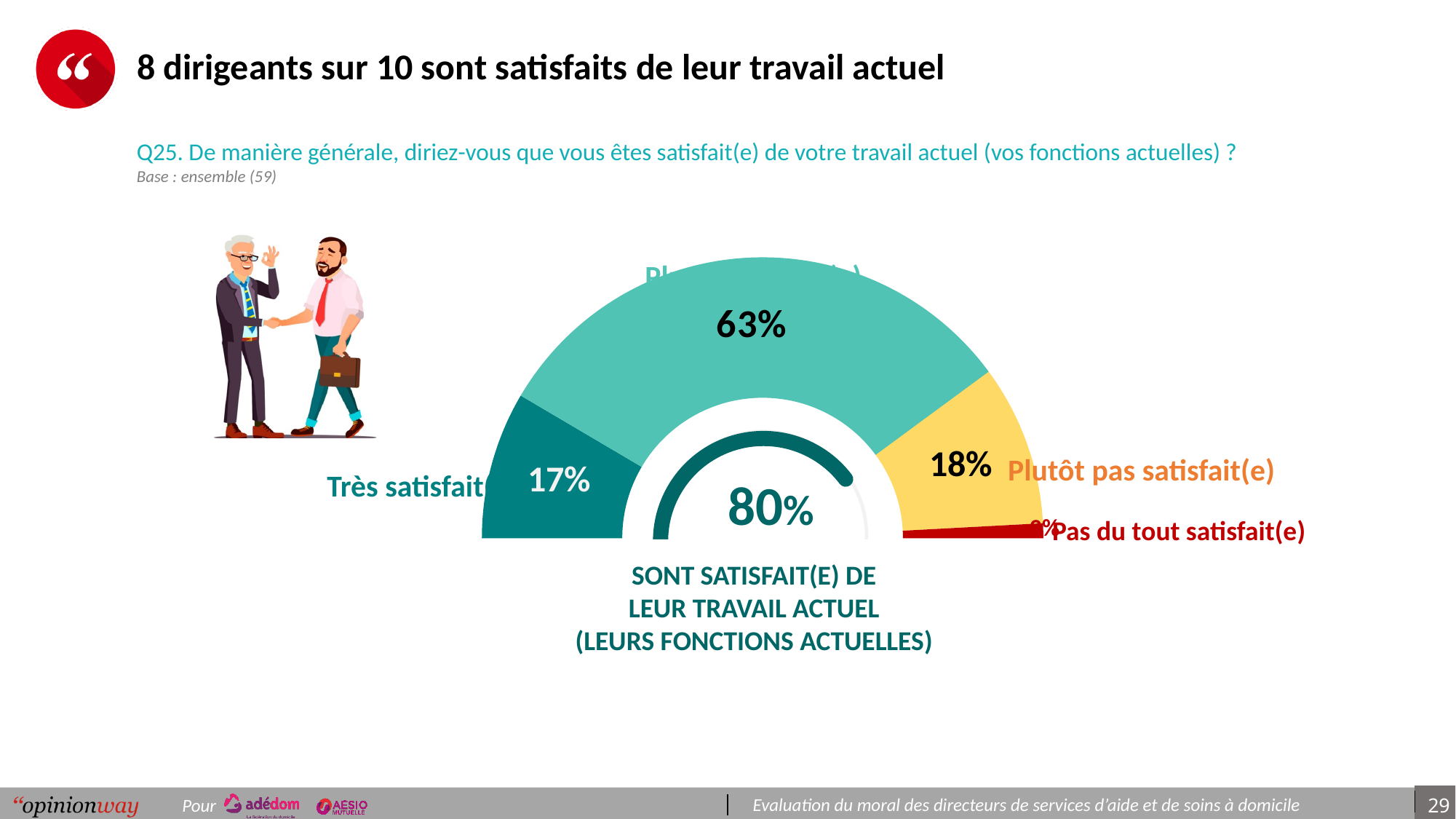
What colour is the "Plutôt pas satisfait(e)" segment? Yellow What percentage of respondents answered "Très satisfait"? 17% Which response category has the smallest segment on the chart? Pas du tout satisfait(e) What is the largest percentage shown on the gauge chart? 63% What is the base (number of respondents) for this question? 59 What is the difference in percentage points between the largest segment (63%) and "Très satisfait" (17%)? 46 points What is the difference in percentage points between "Plutôt pas satisfait(e)" (18%) and "Très satisfait" (17%)? 1 point Which is larger: the share for "Très satisfait" or the share for "Plutôt pas satisfait(e)"? Plutôt pas satisfait(e) How many segments does the gauge chart contain? 4 What percentage of respondents answered "Plutôt pas satisfait(e)"? 18% What kind of chart is used on this slide? A semi-circular doughnut (gauge) chart What total percentage of respondents are satisfied with their current job, as printed in the centre of the chart? 80%